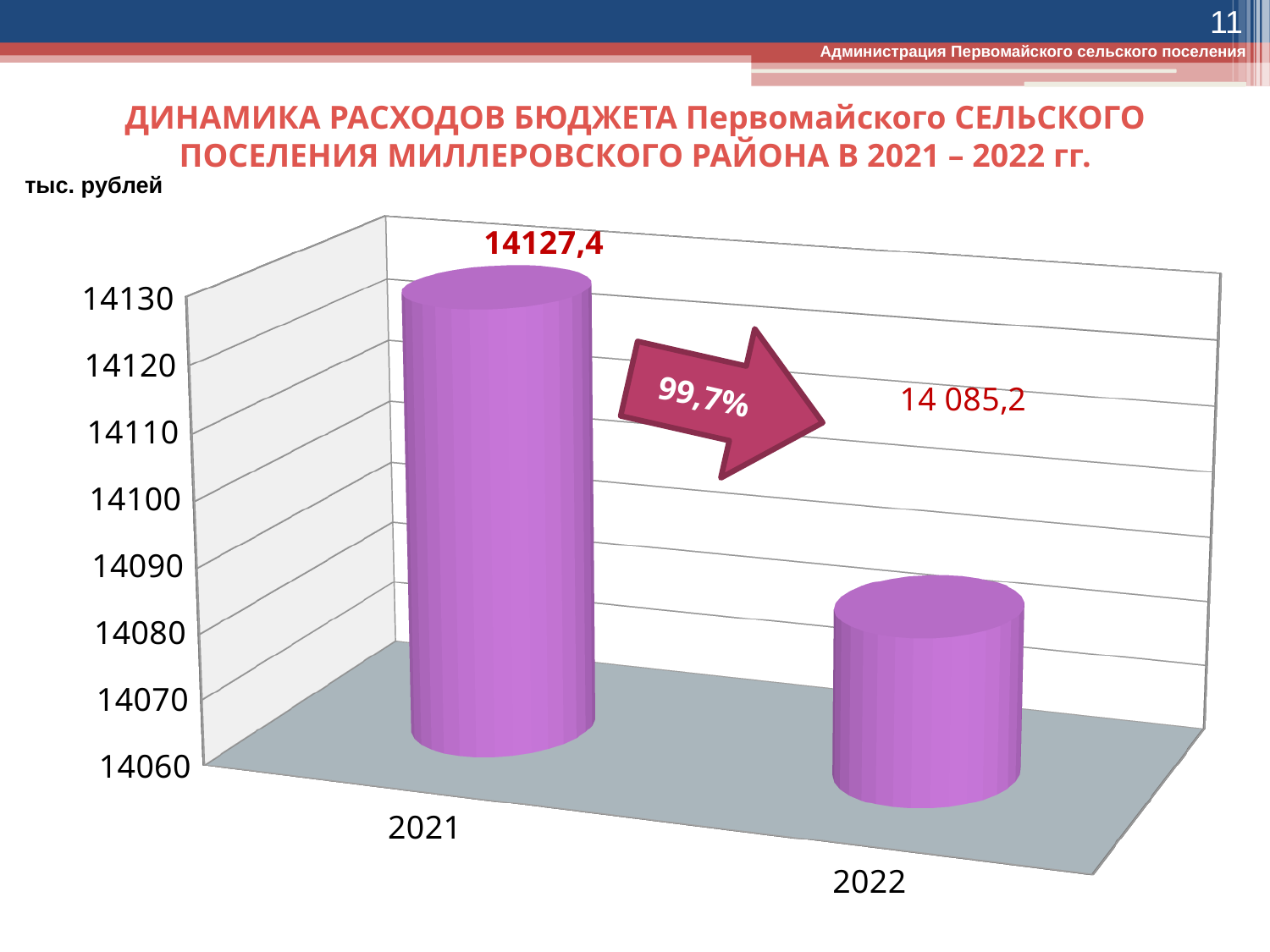
Is the value for 2022 greater or less than 14100? less By how much does the 2021 value exceed the 2022 value? 42,2 How many years (categories) are plotted on the chart? 2 What is the budget expenditure value shown for 2022? 14 085,2 Is the value for 2021 greater or less than 14120? greater Do the values rise or fall from 2021 to 2022? fall What kind of chart is shown on the slide? bar chart What is the budget expenditure value shown for 2021? 14127,4 What percentage is written on the arrow between the two bars? 99,7% Which year has the higher budget expenditure? 2021 Which year has the lower budget expenditure? 2022 In what units are the values on the chart expressed? тыс. рублей